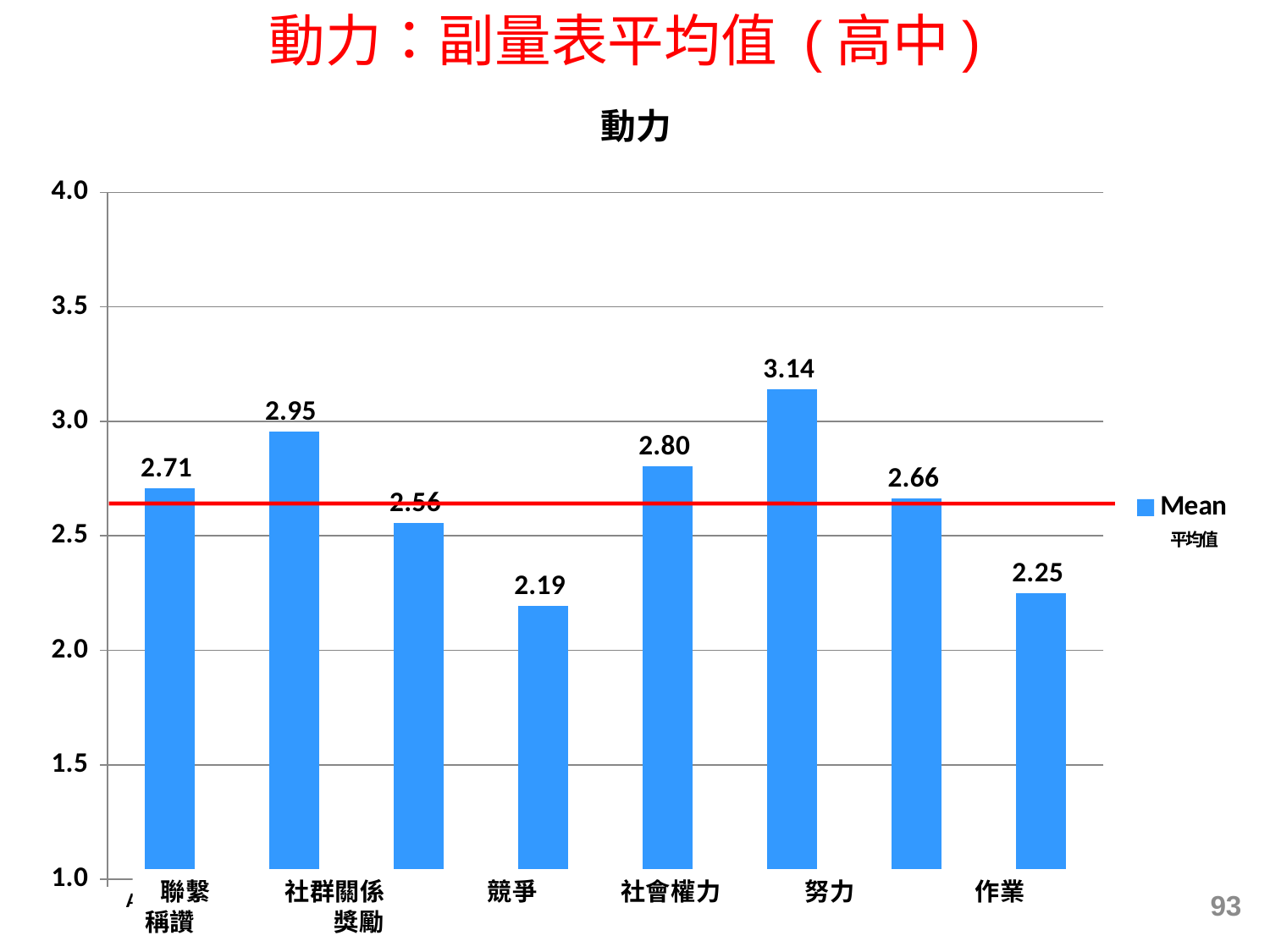
What is the highest value shown on any bar in the chart? 3.14 How many bars have a value less than 2.5? 2 What is the lowest value shown on any bar in the chart? 2.19 What type of chart is shown on the slide? bar chart What is the title of the chart? 動力 How many bars are plotted in the chart? 8 Which is larger, the bar labelled 2.95 or the bar labelled 2.80? 2.95 How many bars have a value greater than 3.0? 1 What is the difference between the highest bar value (3.14) and the lowest bar value (2.19)? 0.95 What is the maximum value shown on the vertical axis? 4.0